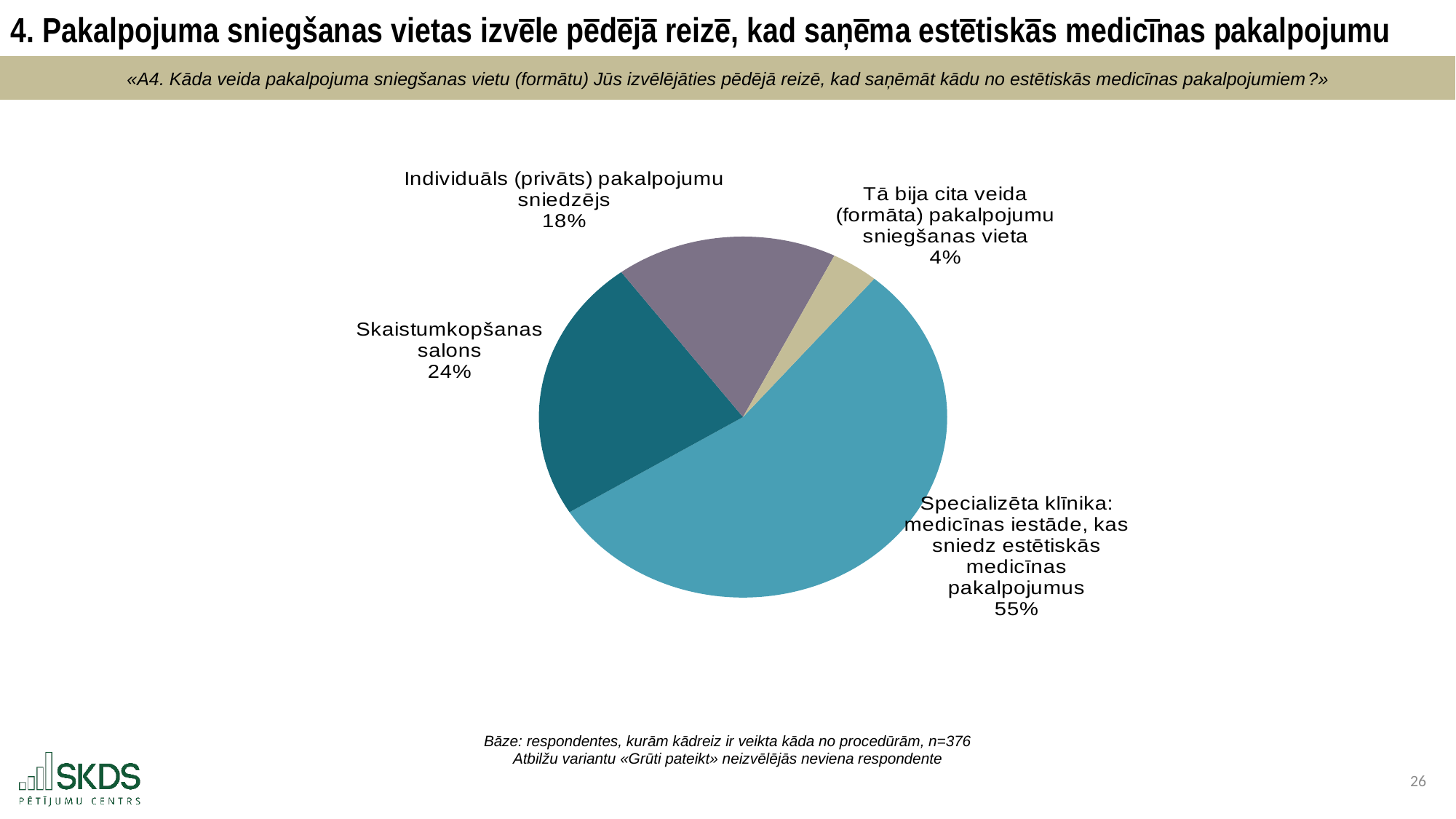
What share of respondents chose "Individuāls (privāts) pakalpojumu sniedzējs"? 18% What share of respondents chose "Tā bija cita veida (formāta) pakalpojumu sniegšanas vieta"? 4% What is the difference in percentage points between "Skaistumkopšanas salons" and "Individuāls (privāts) pakalpojumu sniedzējs"? 6 percentage points Which category has the largest share of the pie? Specializēta klīnika: medicīnas iestāde, kas sniedz estētiskās medicīnas pakalpojumus What is the base size (n) stated below the chart? n=376 What is the difference in percentage points between "Specializēta klīnika" and "Skaistumkopšanas salons"? 31 percentage points Which category has the smallest share of the pie? Tā bija cita veida (formāta) pakalpojumu sniegšanas vieta What kind of chart is shown on the slide? Pie chart What share of respondents chose "Skaistumkopšanas salons"? 24% Which is larger: the share for "Skaistumkopšanas salons" or for "Individuāls (privāts) pakalpojumu sniedzējs"? Skaistumkopšanas salons How many slices does the pie chart have? 4 What share of respondents chose "Specializēta klīnika"? 55%